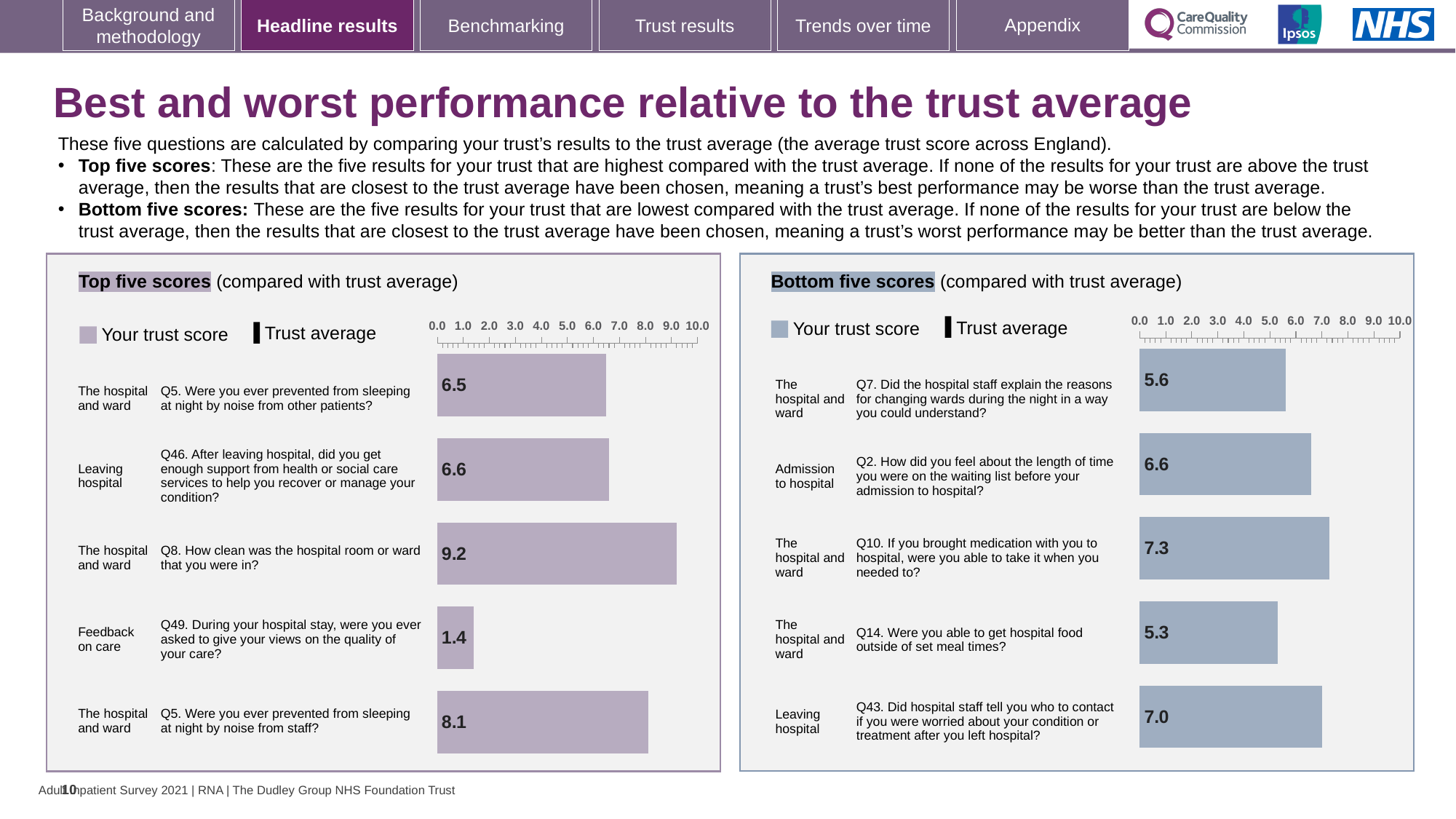
What type of chart is the Top five scores chart? Bar chart In the Bottom five scores chart, what is the trust score for Q14 (Were you able to get hospital food outside of set meal times?)? 5.3 In the Top five scores chart, what is the trust score for Q49 (During your hospital stay, were you ever asked to give your views on the quality of your care?)? 1.4 In the Bottom five scores chart, which question has the lowest trust score? Q14. Were you able to get hospital food outside of set meal times? In the Bottom five scores chart, what is the difference between the trust scores for Q10 and Q7? 1.7 In the Top five scores chart, what is the difference between the trust scores for Q8 and Q49? 7.8 In the Bottom five scores chart, what is the trust score for Q10 (If you brought medication with you to hospital, were you able to take it when you needed to?)? 7.3 In the Top five scores chart, what is the trust score for Q8 (How clean was the hospital room or ward that you were in?)? 9.2 How many questions are shown in the Bottom five scores chart? 5 In the Top five scores chart, which question has the highest trust score? Q8. How clean was the hospital room or ward that you were in? How many entries does the legend of the Top five scores chart list? 2 In the Bottom five scores chart, which has the larger trust score: Q2 (length of time on the waiting list) or Q43 (who to contact if worried after leaving hospital)? Q43